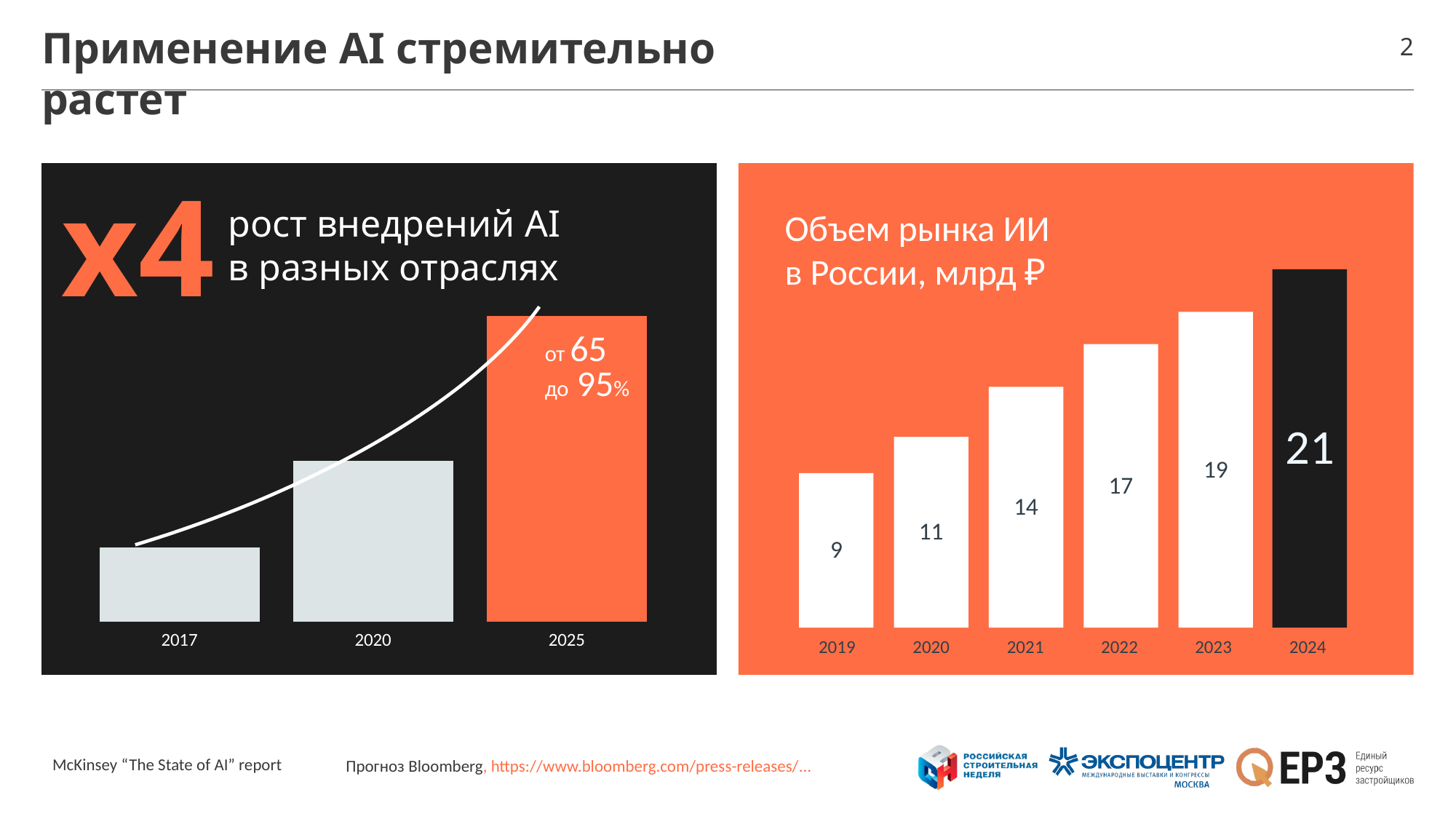
In the chart titled "Объем рынка ИИ в России, млрд ₽", what is the value for 2022? 17 In the chart on the left side of the slide, how many years are shown on the x axis? 3 In the chart titled "Объем рынка ИИ в России, млрд ₽", do the values rise or fall from 2019 to 2024? rise In the chart titled "Объем рынка ИИ в России, млрд ₽", which year has the highest value? 2024 In the chart titled "Объем рынка ИИ в России, млрд ₽", what is the value for 2019? 9 In the chart titled "Объем рынка ИИ в России, млрд ₽", how many years are shown? 6 What kind of chart is the one on the left side of the slide (with years 2017, 2020, 2025)? bar chart In the chart titled "Объем рынка ИИ в России, млрд ₽", what is the difference between the values for 2024 and 2019? 12 In the chart titled "Объем рынка ИИ в России, млрд ₽", which year has the lowest value? 2019 In the chart titled "Объем рынка ИИ в России, млрд ₽", what is the value for 2024? 21 In the chart titled "Объем рынка ИИ в России, млрд ₽", which is larger, the value for 2021 or the value for 2023? 2023 In the chart on the left side of the slide, which year has the tallest bar? 2025